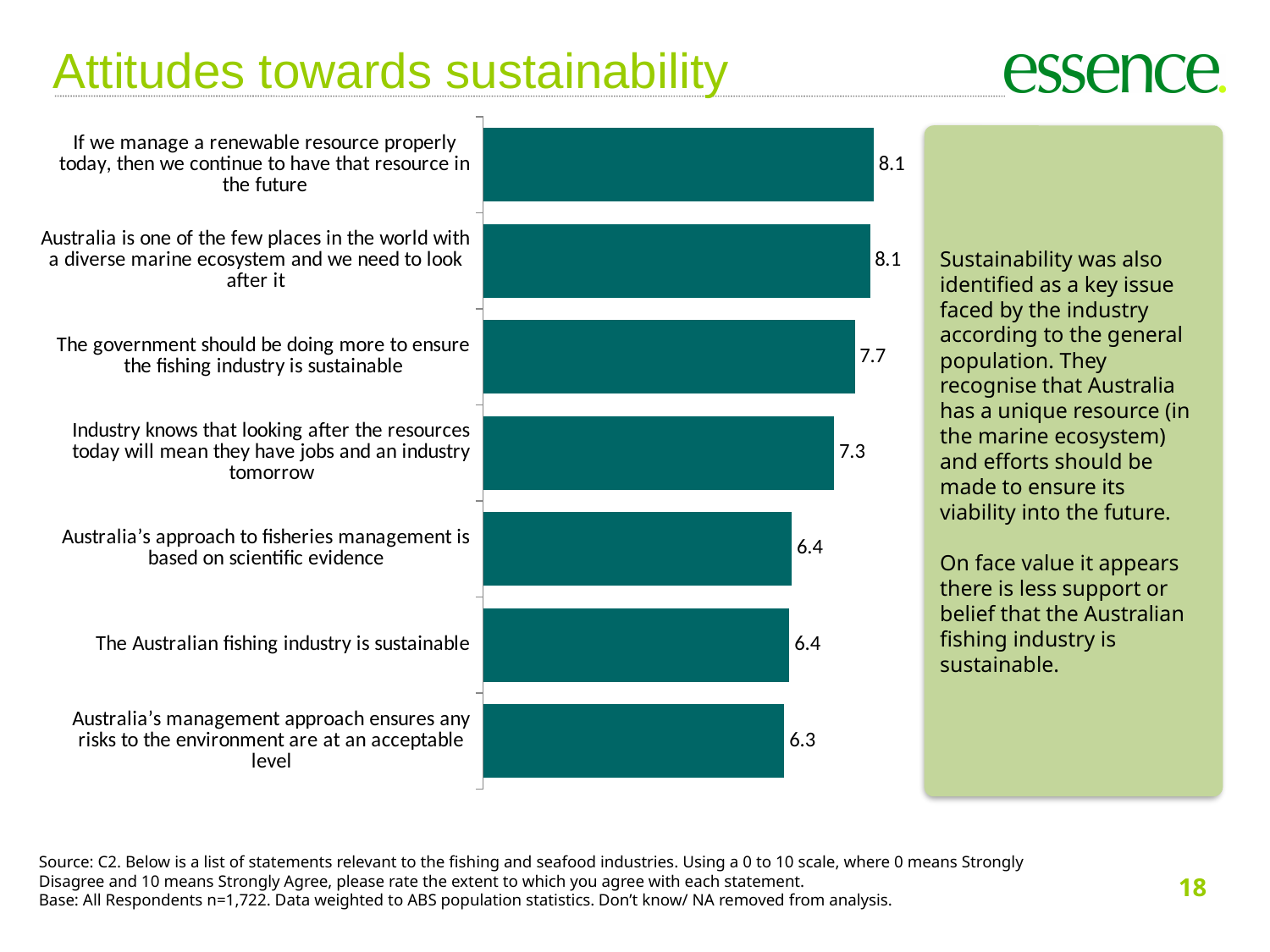
What is the value for "The Australian fishing industry is sustainable"? 6.4 What is the value for "The government should be doing more to ensure the fishing industry is sustainable"? 7.7 What is the title of the slide containing the chart? Attitudes towards sustainability What kind of chart is shown on the slide? Bar chart Which statement has the lowest value? Australia's management approach ensures any risks to the environment are at an acceptable level Which has a larger value: "Australia is one of the few places in the world with a diverse marine ecosystem and we need to look after it" or "Australia's approach to fisheries management is based on scientific evidence"? Australia is one of the few places in the world with a diverse marine ecosystem and we need to look after it What is the difference between the value for "If we manage a renewable resource properly today, then we continue to have that resource in the future" and the value for "The Australian fishing industry is sustainable"? 1.7 What is the value for "Australia's management approach ensures any risks to the environment are at an acceptable level"? 6.3 What is the difference between the value for "The government should be doing more to ensure the fishing industry is sustainable" and the value for "Industry knows that looking after the resources today will mean they have jobs and an industry tomorrow"? 0.4 What is the value for "Industry knows that looking after the resources today will mean they have jobs and an industry tomorrow"? 7.3 How many statements are plotted in the chart? 7 Do the values rise or fall going from the top bar to the bottom bar? Fall